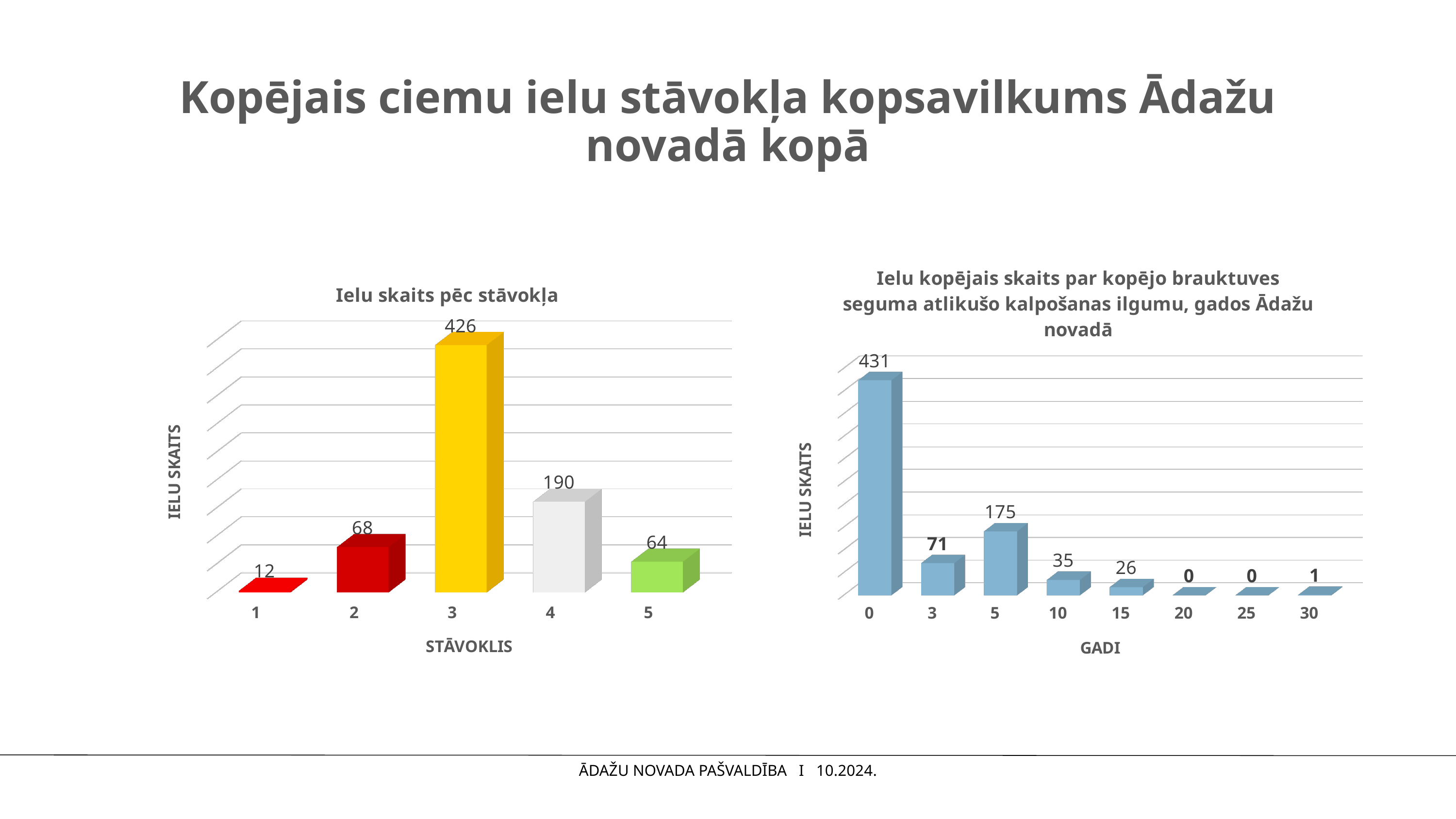
In the right chart, how many categories are shown on the x axis? 8 In the left chart 'Ielu skaits pēc stāvokļa', what colour is the bar for stāvoklis 3? Yellow In the left chart 'Ielu skaits pēc stāvokļa', what is the difference between the values for stāvoklis 4 and stāvoklis 5? 126 In the right chart, what is the value for 5 gadi? 175 In the left chart 'Ielu skaits pēc stāvokļa', how many categories are shown on the x axis? 5 In the right chart, what is the value for 0 gadi? 431 In the left chart 'Ielu skaits pēc stāvokļa', what is the value for stāvoklis 1? 12 What kind of chart is the right chart? Bar chart In the right chart, which gadi category has the highest value? 0 In the left chart 'Ielu skaits pēc stāvokļa', which stāvoklis category has the lowest value? 1 In the right chart, which is larger: the value for 3 gadi or the value for 10 gadi? 3 gadi In the left chart 'Ielu skaits pēc stāvokļa', what is the value for stāvoklis 3? 426